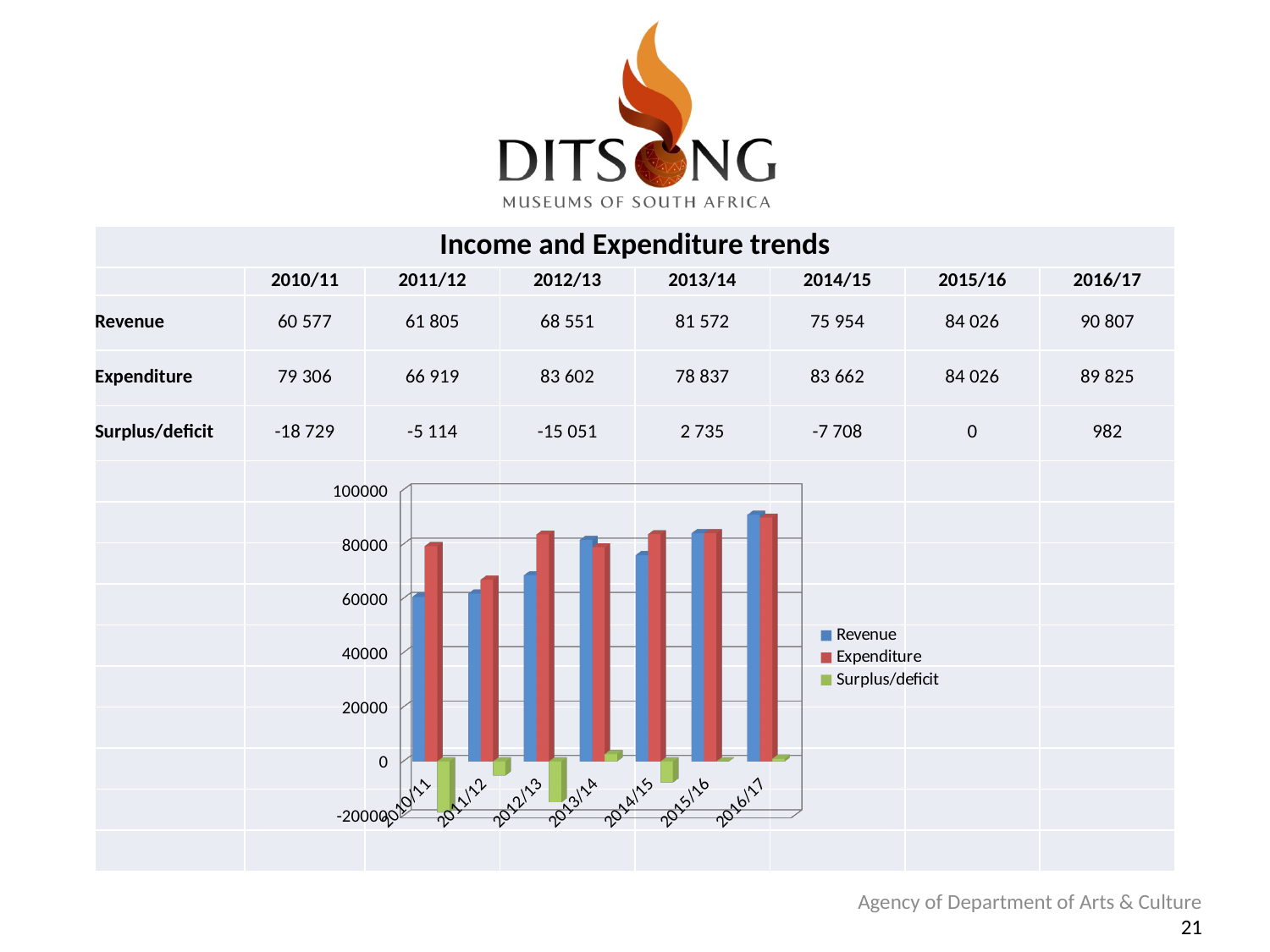
Is the Revenue value for 2013/14 greater or less than 80000? greater What is the difference between Revenue in 2016/17 and Revenue in 2010/11? 30 230 How many series does the chart legend list? 3 What is the Revenue value for 2016/17? 90 807 What kind of chart is shown on the slide? bar chart Does Revenue rise or fall overall from 2010/11 to 2016/17? rise In which year is Revenue highest? 2016/17 In which year is Expenditure lowest? 2011/12 Which is larger in 2012/13, Revenue or Expenditure? Expenditure What is the Surplus/deficit value for 2010/11? -18 729 How many years are shown on the x axis of the chart? 7 What is the Expenditure value for 2012/13? 83 602